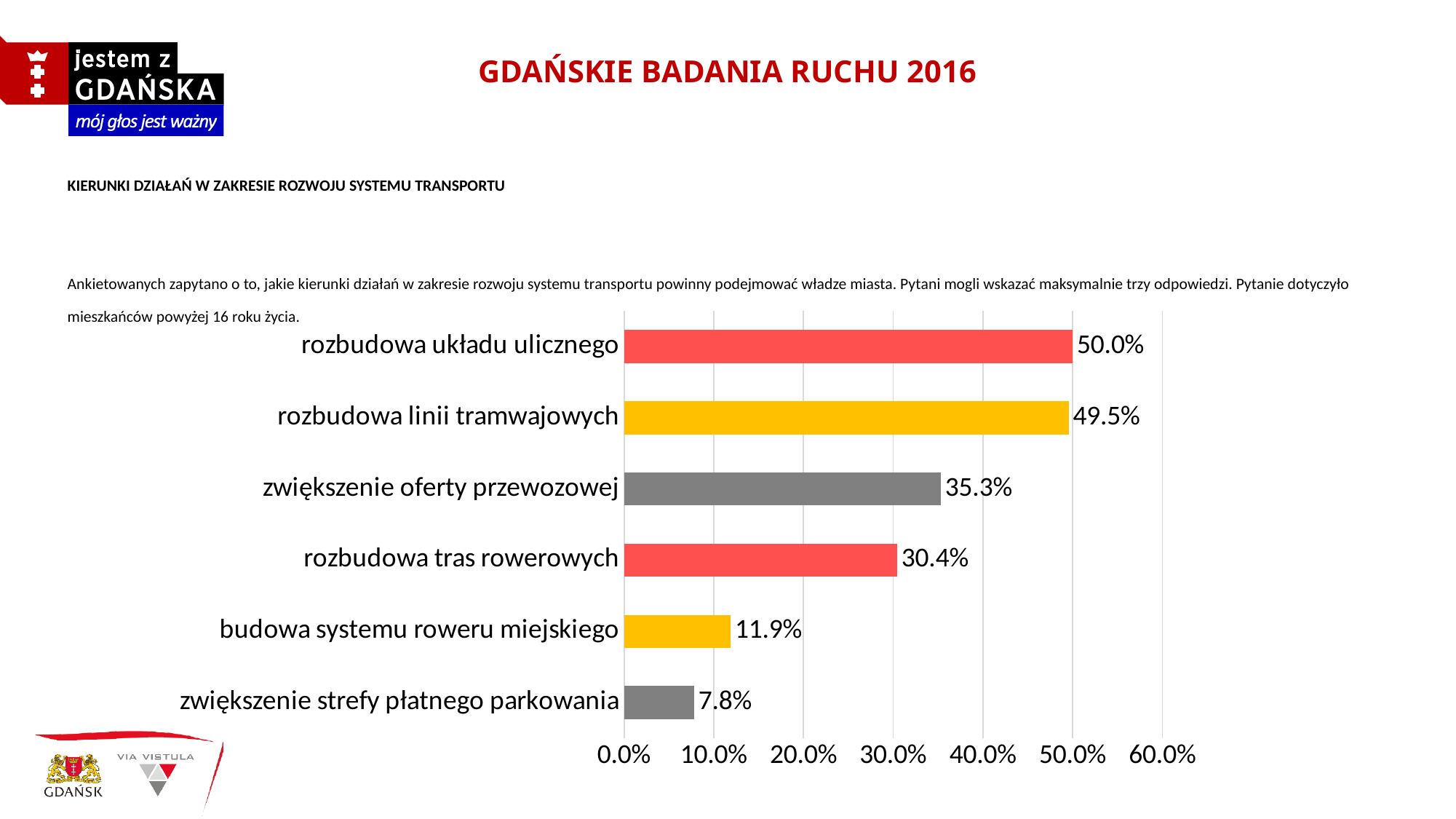
Which category has the lowest value? zwiększenie strefy płatnego parkowania Which category has the highest value? rozbudowa układu ulicznego How many categories are shown in the chart? 6 What kind of chart is shown on the slide? bar chart What is the highest value shown on the x axis? 60.0% What is the value for "rozbudowa układu ulicznego"? 50.0% What is the difference between the values for "zwiększenie oferty przewozowej" and "rozbudowa tras rowerowych"? 4.9% Which is larger, the value for "rozbudowa tras rowerowych" or the value for "budowa systemu roweru miejskiego"? rozbudowa tras rowerowych What is the difference between the values for "rozbudowa układu ulicznego" and "rozbudowa linii tramwajowych"? 0.5% Is the value for "zwiększenie strefy płatnego parkowania" greater or less than 10.0%? less What is the value for "budowa systemu roweru miejskiego"? 11.9% What is the value for "zwiększenie oferty przewozowej"? 35.3%